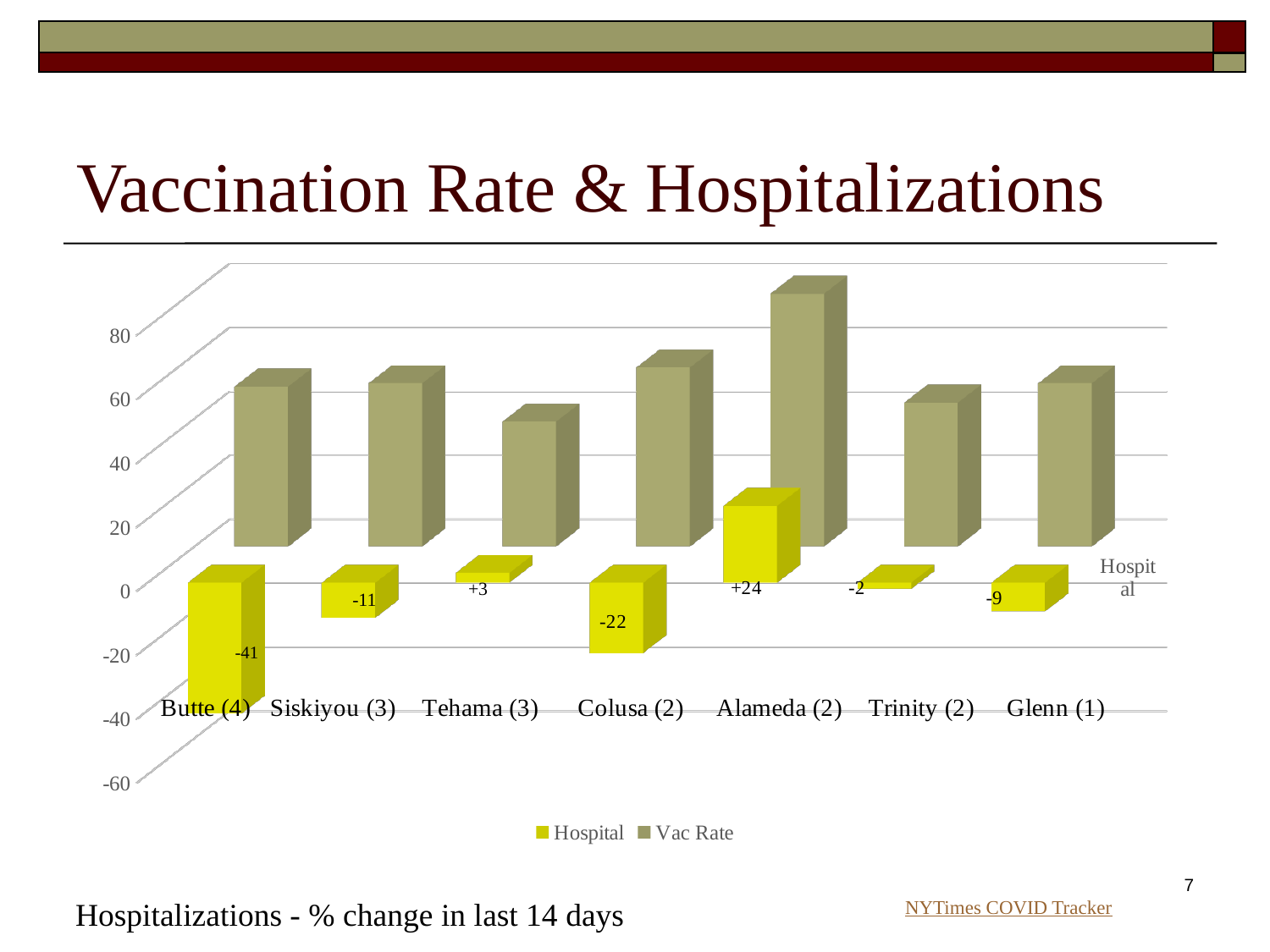
Which county has the highest Hospital value? Alameda (2) How many series does the legend list? 2 What is the Hospital value for Colusa (2)? -22 Which county has the lowest Hospital value? Butte (4) Which has the larger Hospital value, Siskiyou (3) or Glenn (1)? Glenn (1) How many counties are shown on the x axis? 7 What is the Hospital value for Alameda (2)? +24 Is the Vac Rate value for Alameda (2) greater or less than 60? greater What kind of chart is shown on the slide? Bar chart Which county has the highest Vac Rate bar? Alameda (2) What is the Hospital value for Butte (4)? -41 What is the difference between the Hospital values for Alameda (2) and Butte (4)? 65